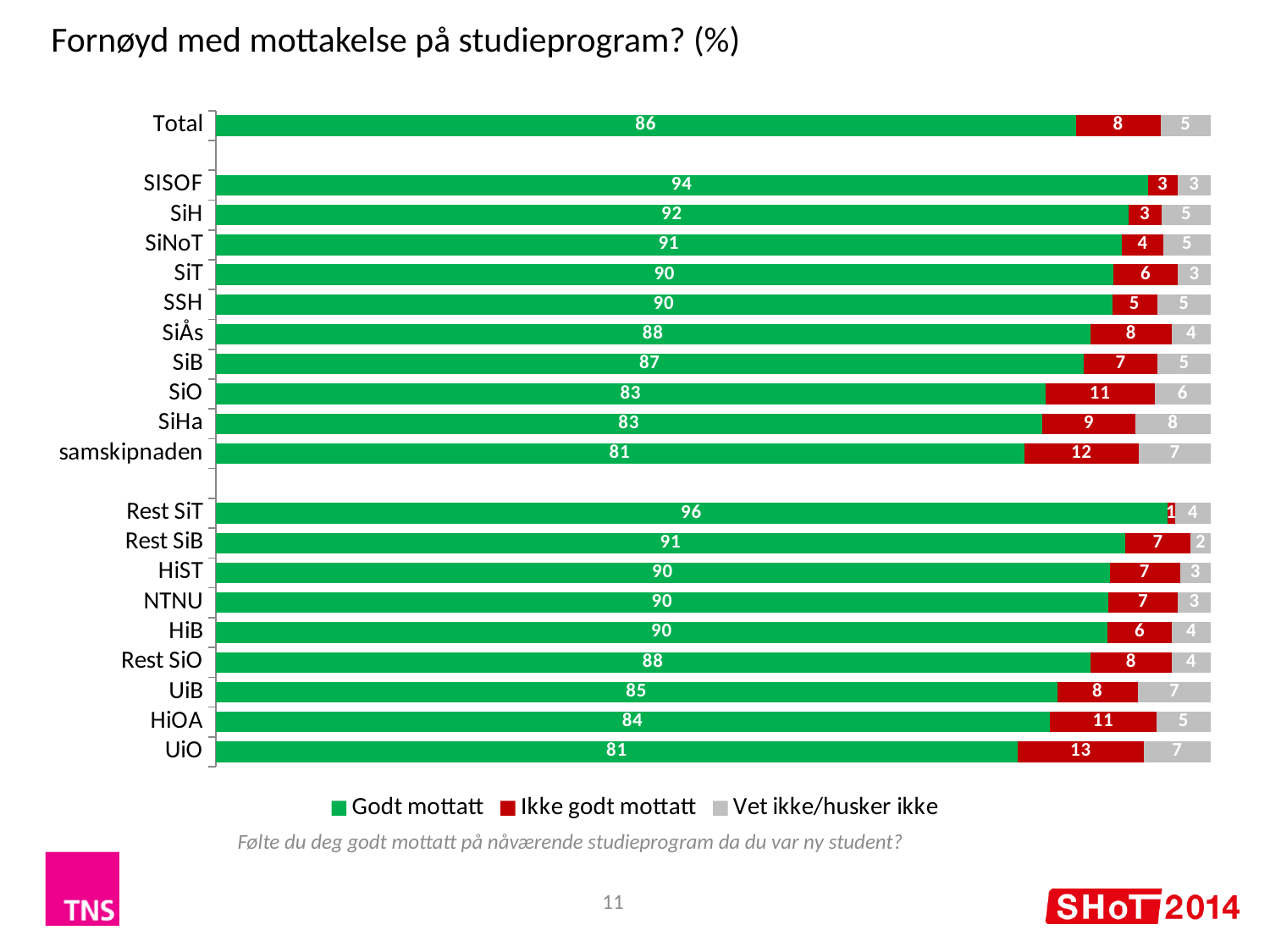
How many categories are shown on the chart? 20 Which category has the lowest 'Ikke godt mottatt' value? Rest SiT Which has a larger 'Ikke godt mottatt' value, SiO or SiB? SiO What kind of chart is shown on the slide? Stacked bar chart What is the total of the stacked bar for HiOA? 100 What is the 'Vet ikke/husker ikke' value for SiHa? 8 What is the 'Ikke godt mottatt' value for UiO? 13 How many series does the legend list? 3 What is the difference between the 'Godt mottatt' values for SISOF and samskipnaden? 13 What is the 'Godt mottatt' value for Total? 86 Which series is shown in green? Godt mottatt Which category has the highest 'Godt mottatt' value? Rest SiT